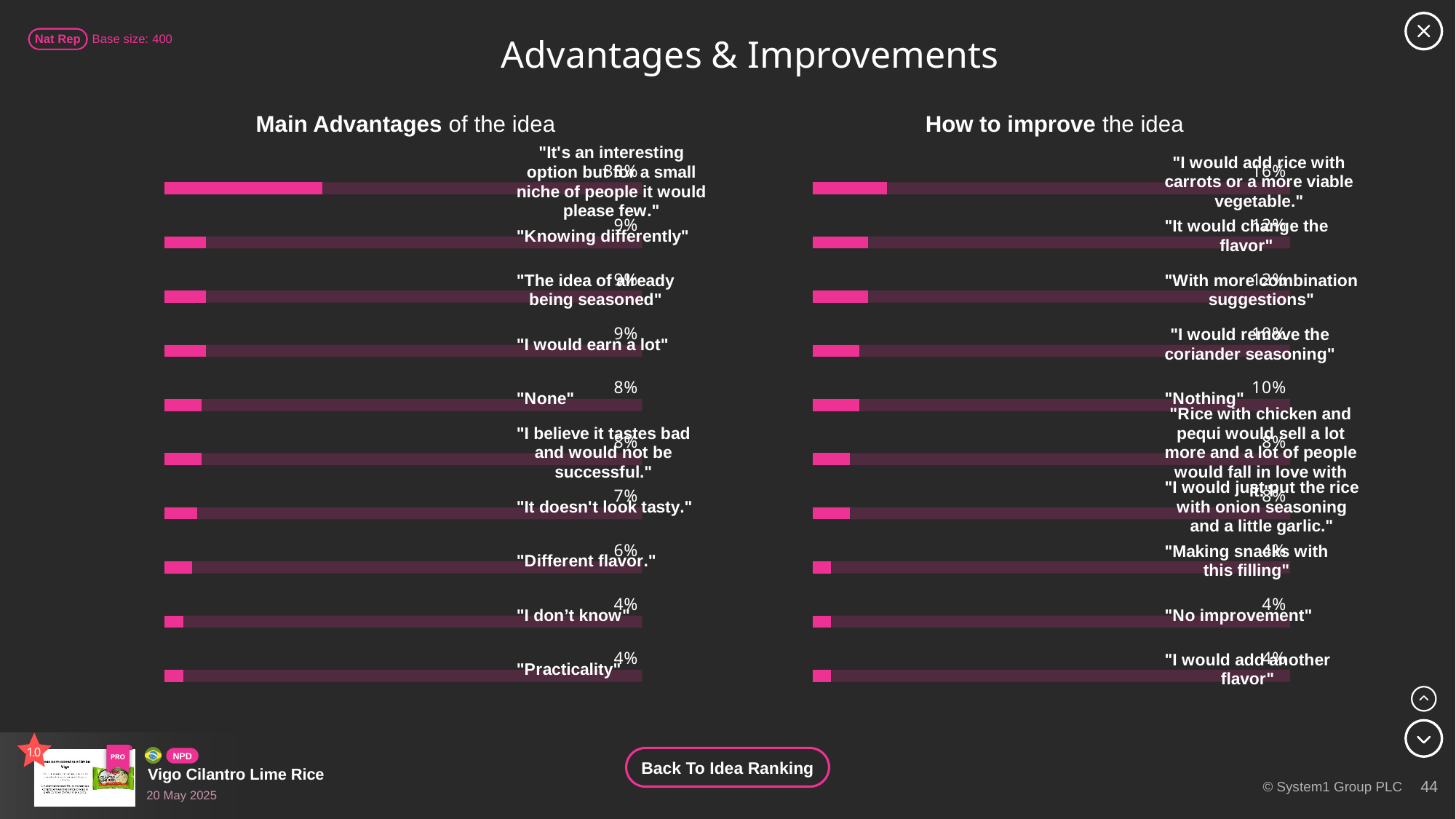
How many responses are listed on the 'How to improve the idea' chart? 10 On the 'Main Advantages of the idea' chart, which response has the highest percentage? "It's an interesting option but for a small niche of people it would please few." On the 'How to improve the idea' chart, what percentage is shown for "No improvement"? 4% On the 'How to improve the idea' chart, what percentage is shown for "Nothing"? 10% What kind of chart is used for 'How to improve the idea'? Bar chart On the 'How to improve the idea' chart, which is larger: "I would remove the coriander seasoning" or "Making snacks with this filling"? "I would remove the coriander seasoning" On the 'How to improve the idea' chart, what percentage is shown for "I would add rice with carrots or a more viable vegetable."? 16% On the 'Main Advantages of the idea' chart, what percentage is shown for "Different flavor."? 6% On the 'Main Advantages of the idea' chart, what percentage is shown for "None"? 8% How many responses are listed on the 'Main Advantages of the idea' chart? 10 On the 'How to improve the idea' chart, what is the difference in percentage points between "I would add rice with carrots or a more viable vegetable." and "It would change the flavor"? 4 On the 'Main Advantages of the idea' chart, what percentage is shown for "It doesn't look tasty."? 7%